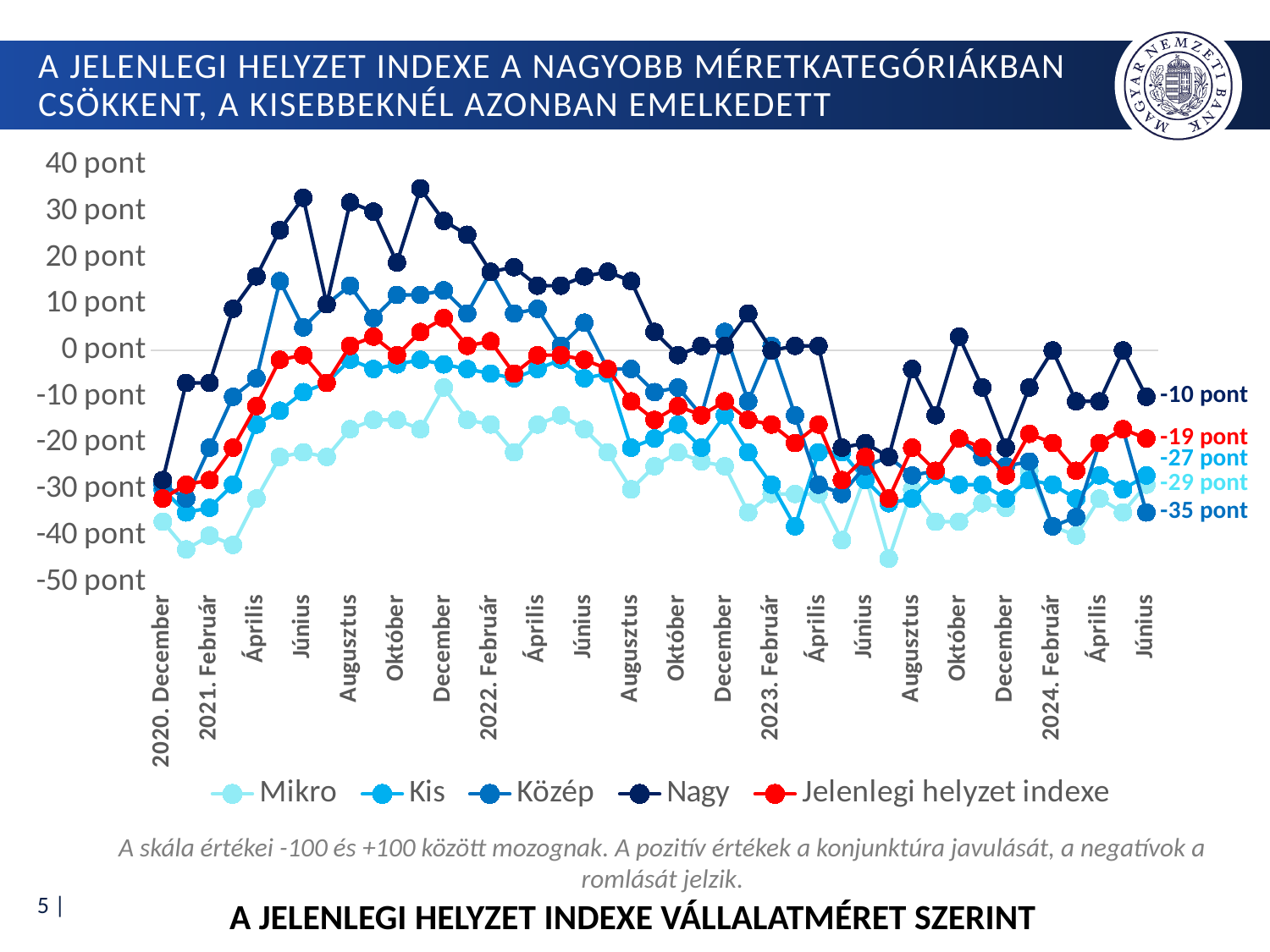
What is the difference between the Jelenlegi helyzet indexe value (-19 pont) and the Közép value (-35 pont) at the last point? 16 pont At the last point (2024 Június), which series has the highest value? Nagy What kind of chart is shown on the slide? line chart What is the difference between the Nagy value (-10 pont) and the Jelenlegi helyzet indexe value (-19 pont) at the last point? 9 pont What is the value of the Közép series at the last point (2024 Június)? -35 pont Is the value of the Nagy series in 2021 Június greater or less than 20 pont? greater At the last point, which is larger: the Nagy value or the Jelenlegi helyzet indexe value? Nagy What is the value of the Jelenlegi helyzet indexe series at the last point (2024 Június)? -19 pont How many series does the legend list? 5 At the last point (2024 Június), which series has the lowest value? Közép Does the Nagy series rise or fall overall from 2021 Június to 2024 Június? fall What is the value of the Nagy series at the last point (2024 Június)? -10 pont